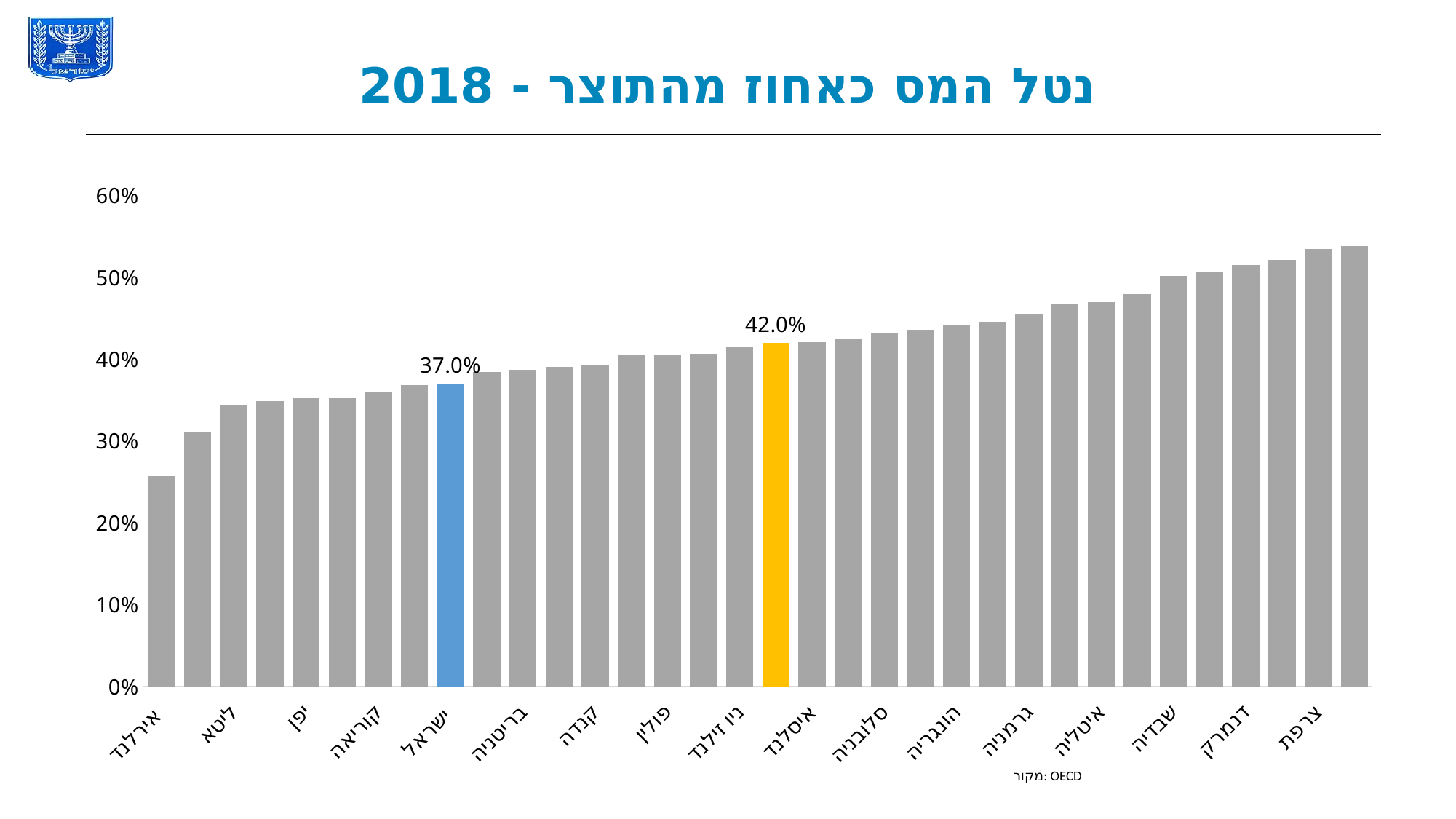
Do the values rise or fall from left to right along the x axis? rise Is the value for גרמניה greater or less than 40%? greater Which labelled country has the highest value? צרפת What is the value shown for ישראל? 37.0% Which has a larger value, ישראל or איסלנד? איסלנד What kind of chart is shown on the slide? bar chart Is the value for יפן greater or less than 40%? less Which labelled country has the lowest value? אירלנד Is the value for צרפת greater or less than 50%? greater